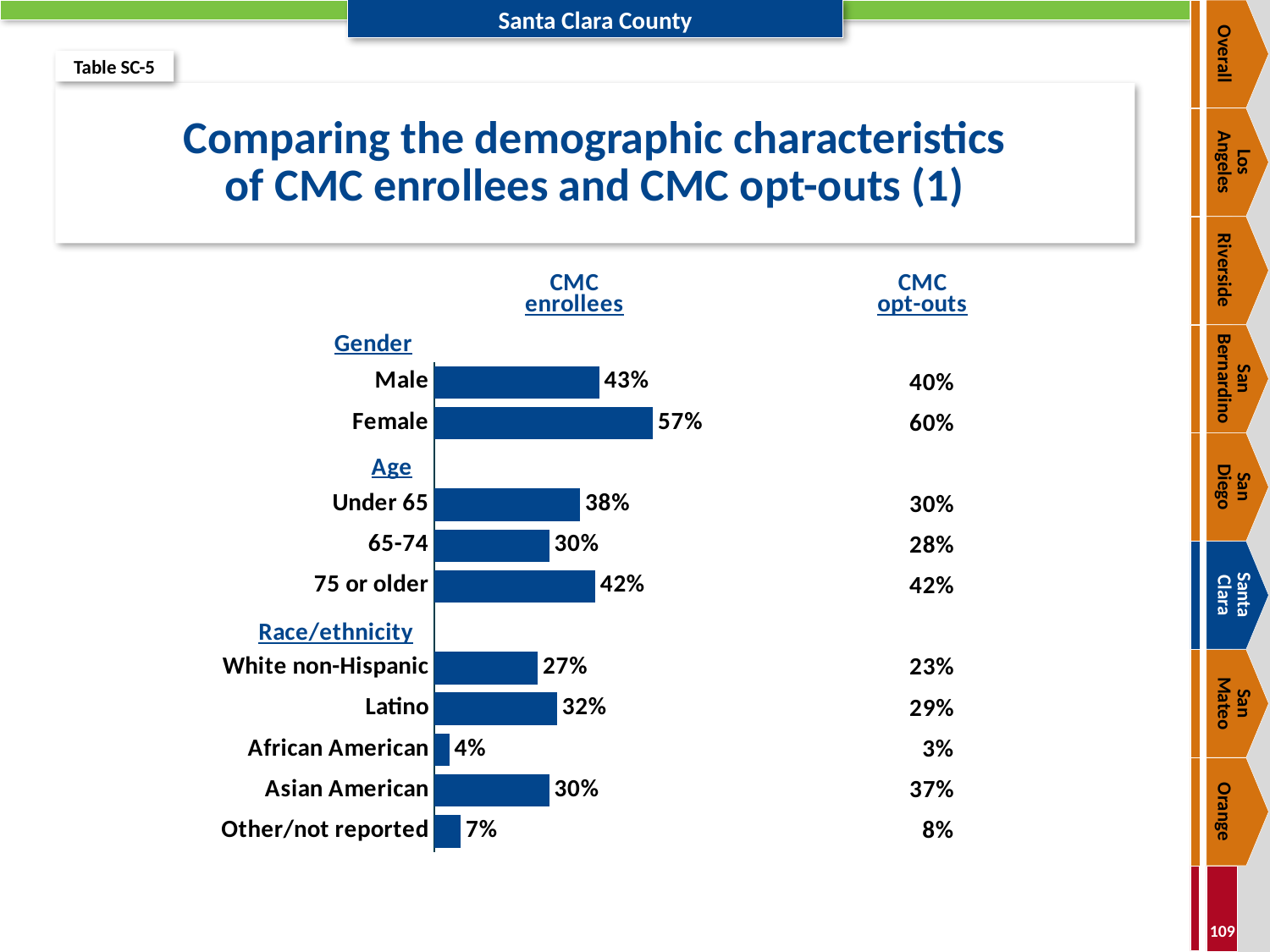
What percentage of CMC enrollees are Asian American? 30% What is the difference between the Female and Male percentages for CMC enrollees? 14% What is the difference between the Asian American percentage for CMC opt-outs and for CMC enrollees? 7% Which is larger: the Under 65 percentage for CMC enrollees or for CMC opt-outs? CMC enrollees What percentage of CMC opt-outs are Under 65? 30% What type of chart is used to show the CMC enrollees percentages? Bar chart What percentage of CMC enrollees are Female? 57% What is the title of the slide's chart? Comparing the demographic characteristics of CMC enrollees and CMC opt-outs (1) Which age group has the highest percentage of CMC enrollees? 75 or older Which race/ethnicity category has the lowest percentage of CMC enrollees? African American How many categories have bars plotted in the CMC enrollees chart? 10 Which is larger for CMC enrollees: the Latino percentage or the White non-Hispanic percentage? Latino